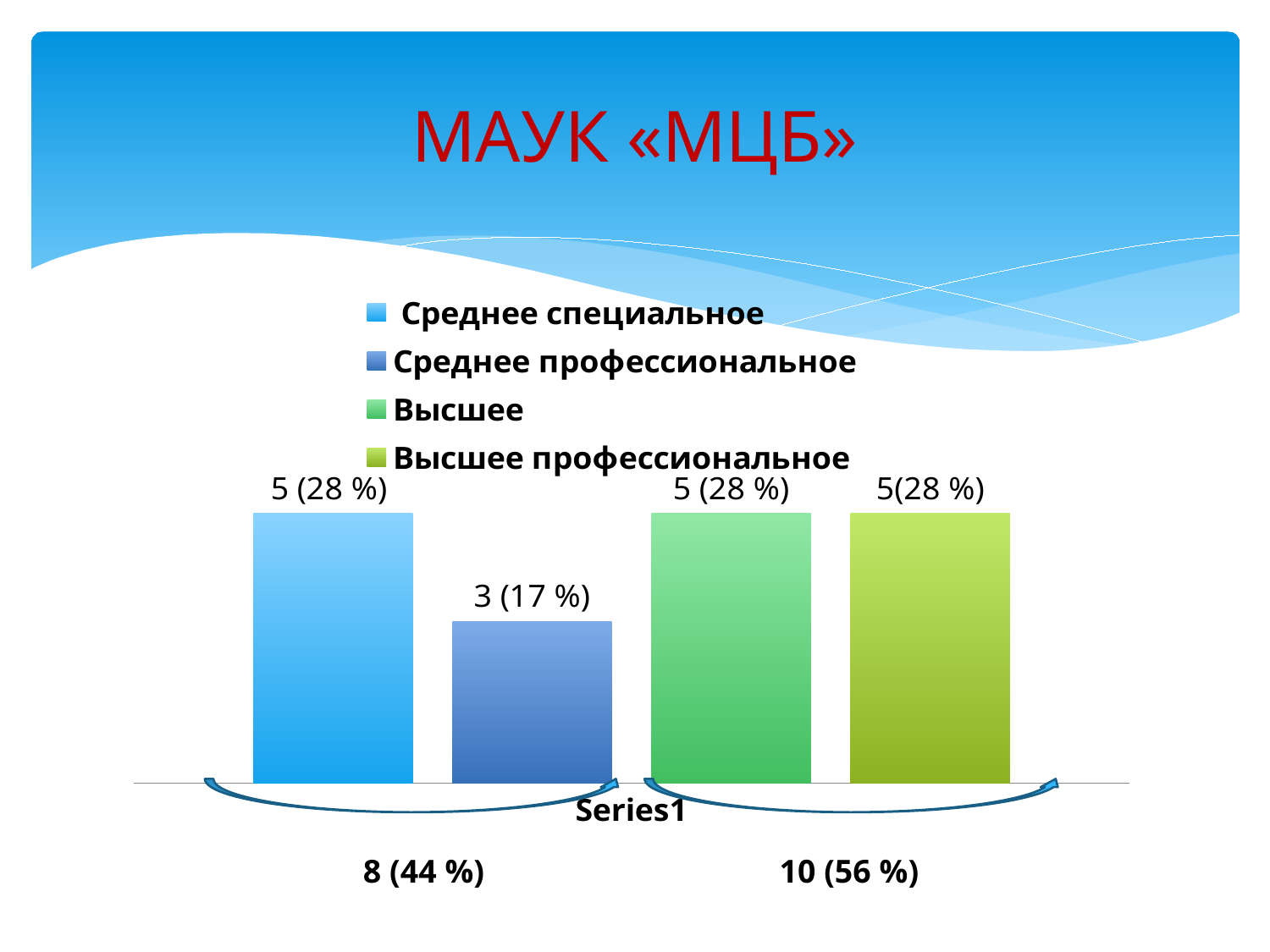
What is the data label on the bar for Среднее специальное? 5 (28 %) What is the title of the slide above the chart? МАУК «МЦБ» What is the data label on the bar for Высшее профессиональное? 5(28 %) Which series has the lowest bar? Среднее профессиональное How many bars are plotted in the chart? 4 What is the difference between the count for Высшее and the count for Среднее профессиональное? 2 How many series does the legend list? 4 What is the data label on the bar for Высшее? 5 (28 %) What label is shown on the category axis below the bars? Series1 Which is larger, the value for Среднее специальное or the value for Среднее профессиональное? Среднее специальное What kind of chart is shown on the slide? bar chart What is the data label on the bar for Среднее профессиональное? 3 (17 %)